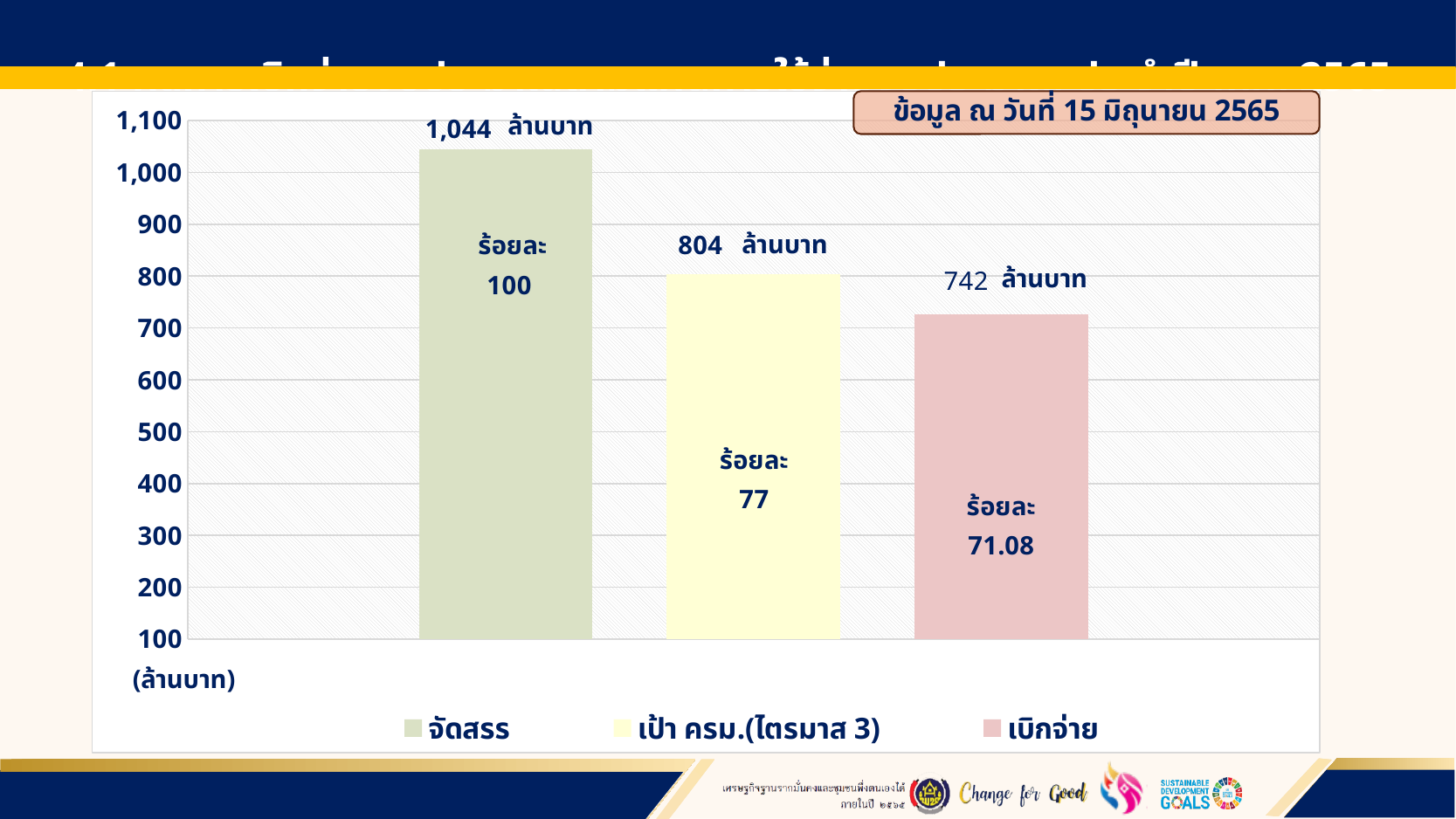
Which is larger, the value for เป้า ครม.(ไตรมาส 3) or the value for เบิกจ่าย? เป้า ครม.(ไตรมาส 3) Which category has the lowest value? เบิกจ่าย What percentage (ร้อยละ) is printed on the เป้า ครม.(ไตรมาส 3) bar? 77 What value is shown for เป้า ครม.(ไตรมาส 3)? 804 ล้านบาท Which category has the highest value? จัดสรร How many series does the legend list? 3 What value is shown for เบิกจ่าย? 742 ล้านบาท What is the difference between the จัดสรร value and the เบิกจ่าย value? 302 ล้านบาท What percentage (ร้อยละ) is printed on the เบิกจ่าย bar? 71.08 What kind of chart is shown on the slide? Bar chart How many bars are shown in the chart? 3 What value is shown for จัดสรร? 1,044 ล้านบาท